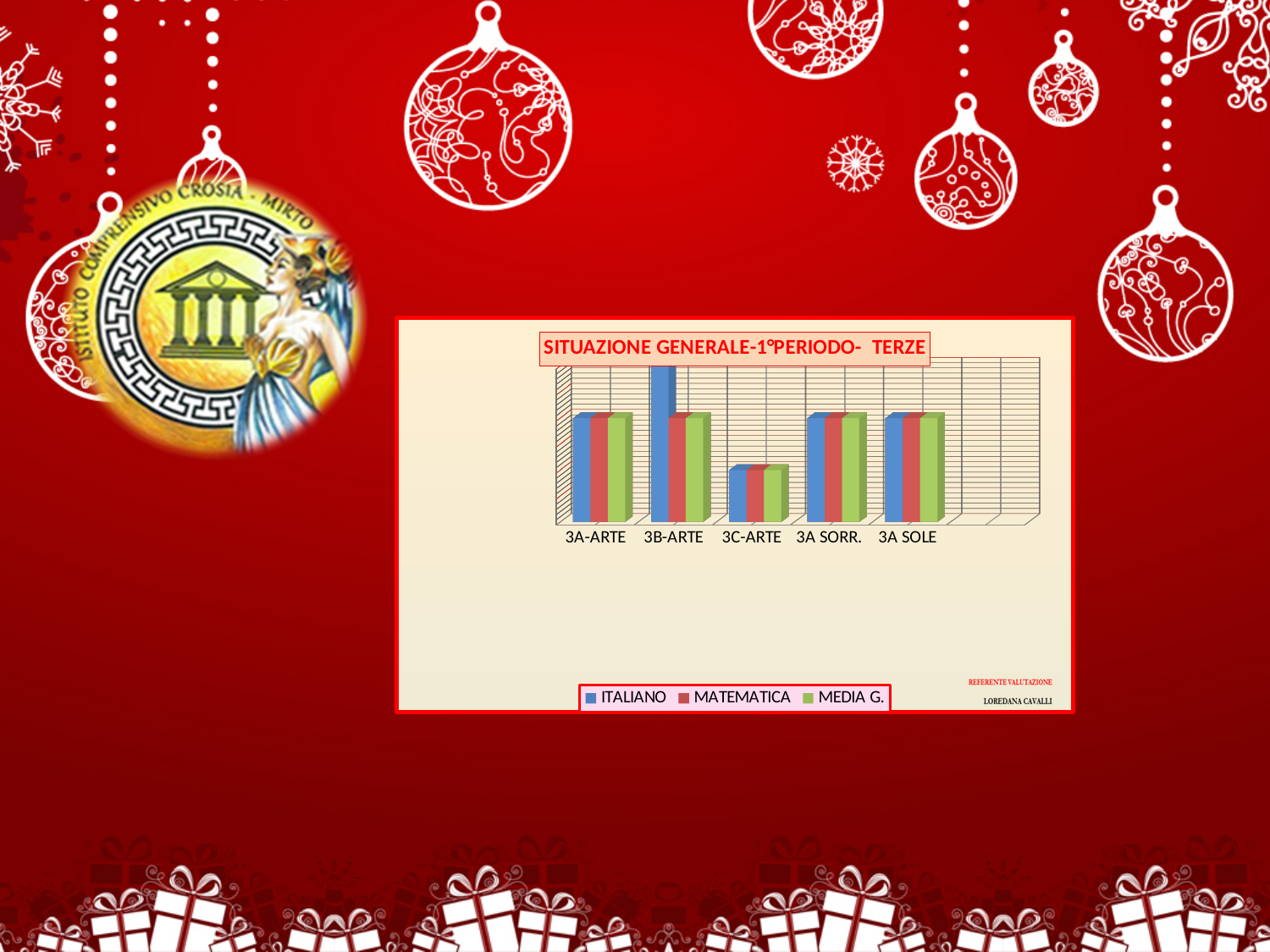
How many series does the chart's legend list? 3 Which category has the tallest ITALIANO bar? 3B-ARTE Which category has the lowest bars in the chart? 3C-ARTE What kind of chart is shown on the slide? bar chart What is the title of the chart? SITUAZIONE GENERALE-1°PERIODO- TERZE How many categories are shown on the x axis of the chart? 5 Which series is shown in green in the chart's legend? MEDIA G. Is the ITALIANO value for 3B-ARTE larger or smaller than the ITALIANO value for 3C-ARTE? larger Which category is listed first on the x axis of the chart? 3A-ARTE Which series has the tallest bar in the 3B-ARTE category? ITALIANO Is the MATEMATICA value for 3C-ARTE larger or smaller than the MATEMATICA value for 3A SORR.? smaller